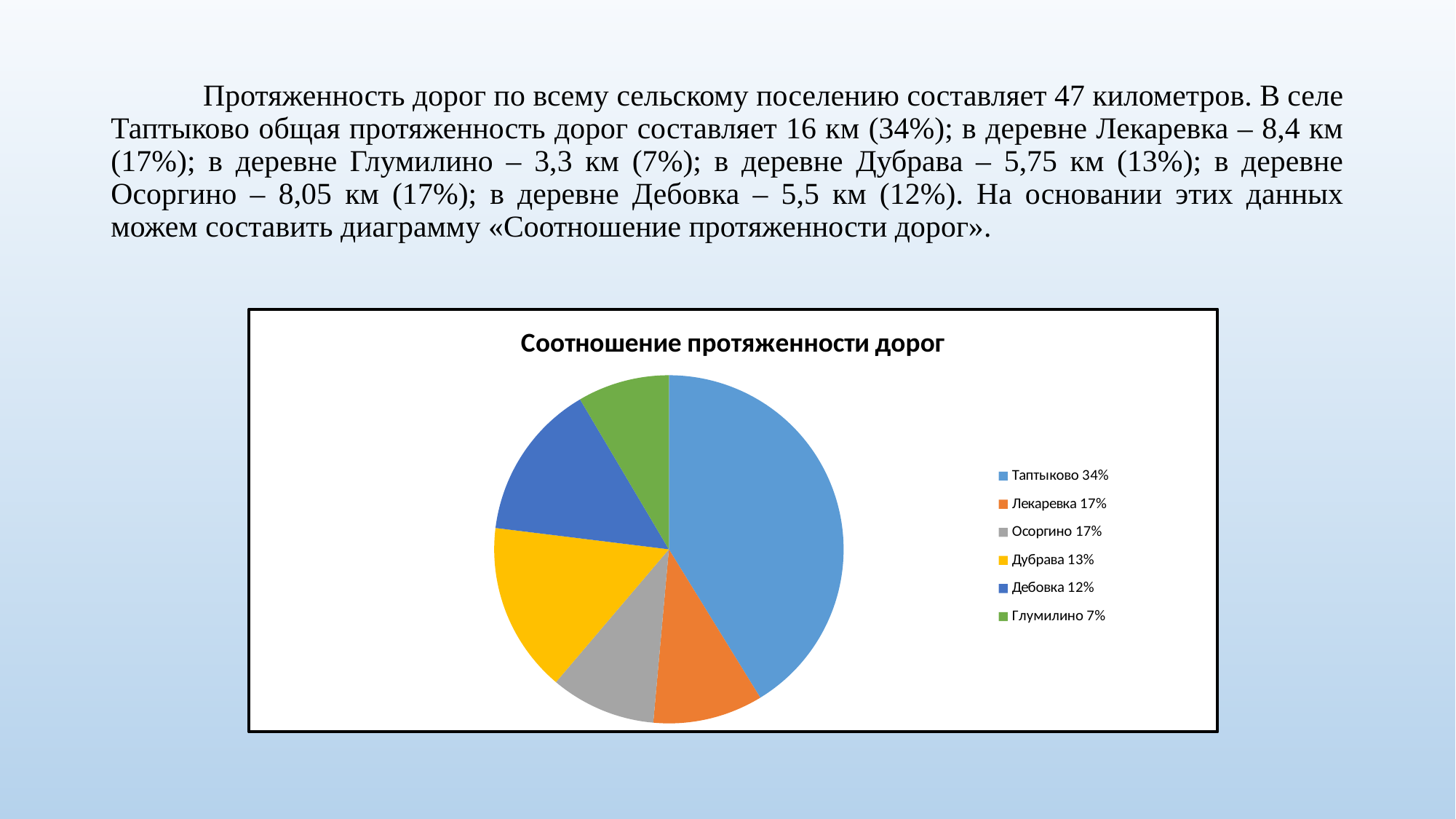
What kind of chart is shown on the slide? Pie chart What share of the pie does Таптыково have? 34% What percentage is shown for Дубрава in the legend? 13% What colour is the slice for Осоргино? Grey What is the title of the chart? Соотношение протяженности дорог Which category has the largest share of the pie? Таптыково What is the difference in percentage points between Таптыково and Глумилино? 27% Which has the larger share, Дубрава or Дебовка? Дубрава How many slices does the pie chart have? 6 What percentage is shown for Дебовка? 12% What percentage is shown for Глумилино? 7% Which category has the smallest share of the pie? Глумилино